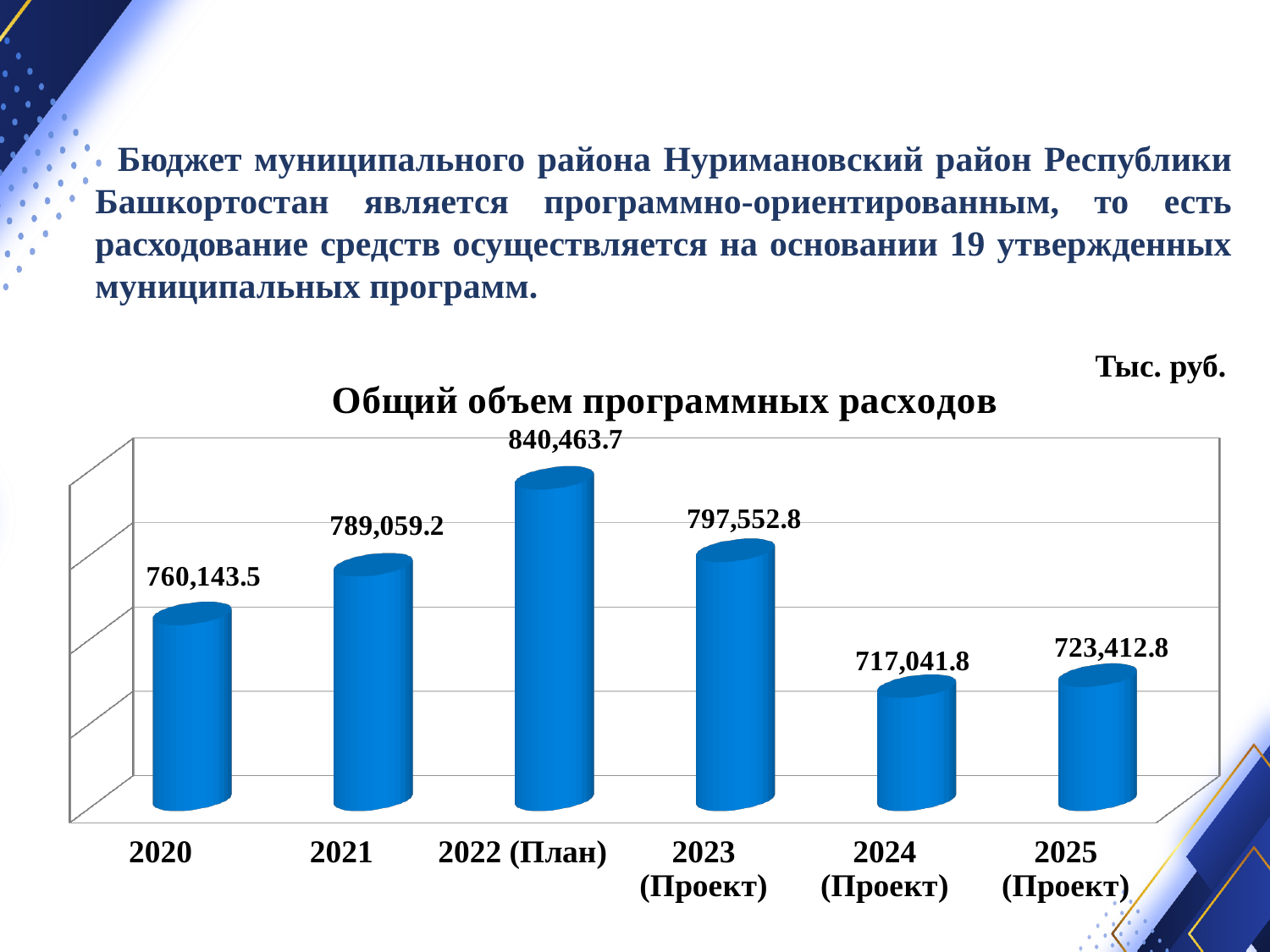
What kind of chart is shown on the slide? Bar chart How many years are shown in the chart? 6 What is the difference between the values for 2025 (Проект) and 2024 (Проект)? 6,371.0 What unit of measurement is indicated for the chart? Тыс. руб. What is the value for 2022 (План)? 840,463.7 Which year has the lowest value in the chart? 2024 (Проект) What is the value for 2020 in the chart "Общий объем программных расходов"? 760,143.5 Which is larger, the value for 2021 or the value for 2023 (Проект)? 2023 (Проект) What is the difference between the values for 2022 (План) and 2020? 80,320.2 What is the value for 2024 (Проект)? 717,041.8 Which year has the highest value in the chart? 2022 (План) What is the value for 2025 (Проект)? 723,412.8